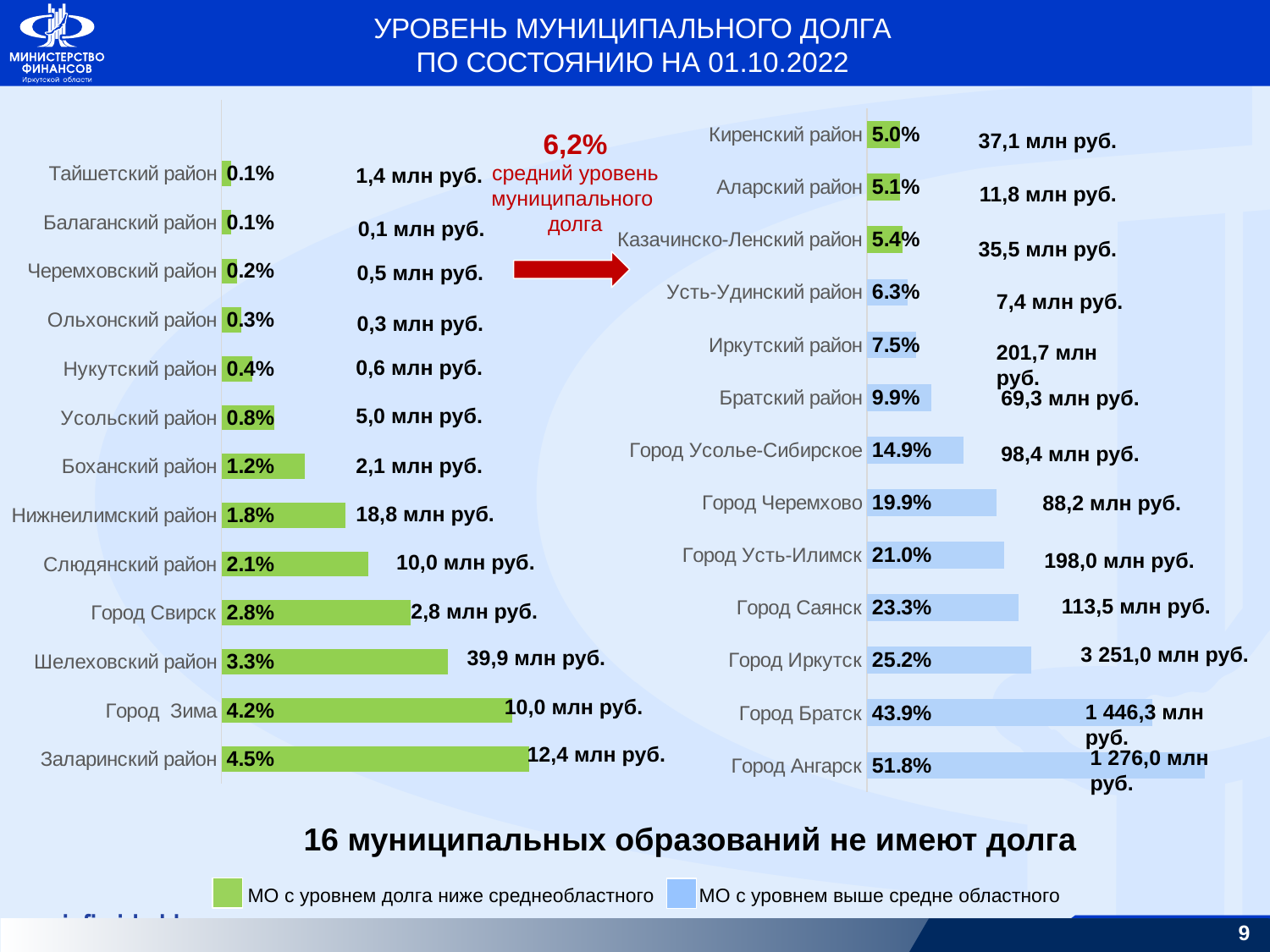
How many municipalities are shown on the right (blue) chart? 13 What type of chart is used on the slide to show municipal debt levels? Bar chart On the right (blue) chart, do the debt levels rise or fall going from top to bottom? Rise On the right (blue) chart, which municipality has the highest debt level? Город Ангарск What average municipal debt level is stated on the slide? 6,2% On the left (green) chart, what is the municipal debt level for Шелеховский район? 3.3% How many municipalities are shown on the left (green) chart? 13 On the right (blue) chart, which municipality has the lowest debt level? Киренский район On the right (blue) chart, what is the municipal debt level for Город Иркутск? 25.2% On the left (green) chart, which has a higher debt level: Город Зима or Слюдянский район? Город Зима On the left (green) chart, which municipality has the highest debt level? Заларинский район On the right (blue) chart, what is the difference in debt level between Город Ангарск and Город Братск? 7.9%